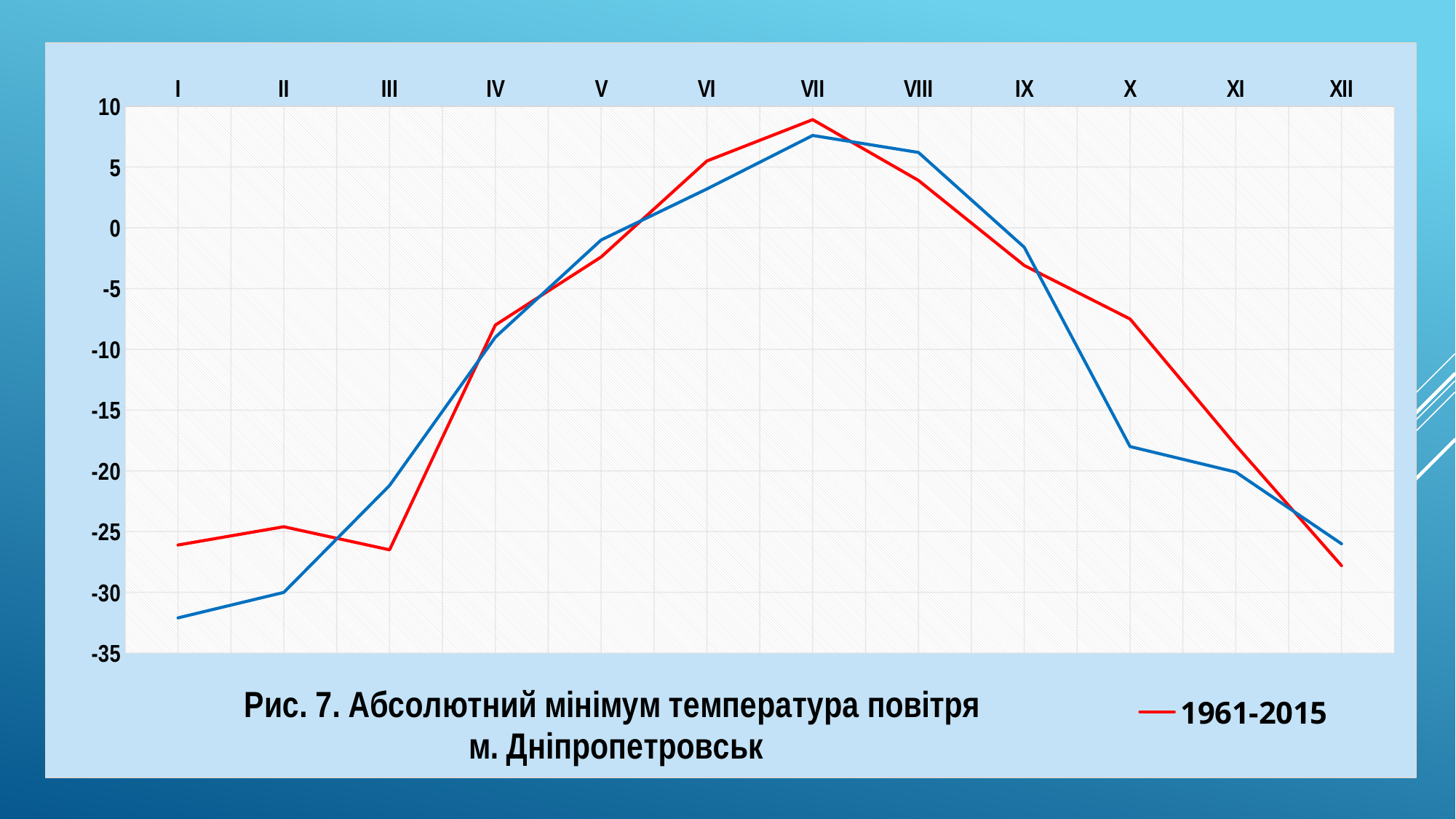
In which month does the red 1961-2015 line reach its highest value? VII In which month does the blue line reach its lowest value? I How many series does the legend list? 1 In which month does the blue line reach its highest value? VII In which month does the red 1961-2015 line reach its lowest value? XII What label does the legend give for the red line? 1961-2015 Is the value of the blue line in month X greater or less than -15? less Does the blue line rise or fall from month VII to month XI? fall In month I, which line has the higher value, the red 1961-2015 line or the blue line? red 1961-2015 line What kind of chart is shown on the slide? line chart How many months (categories) are plotted along the x axis? 12 Is the value of the red 1961-2015 line in month X greater or less than -10? greater